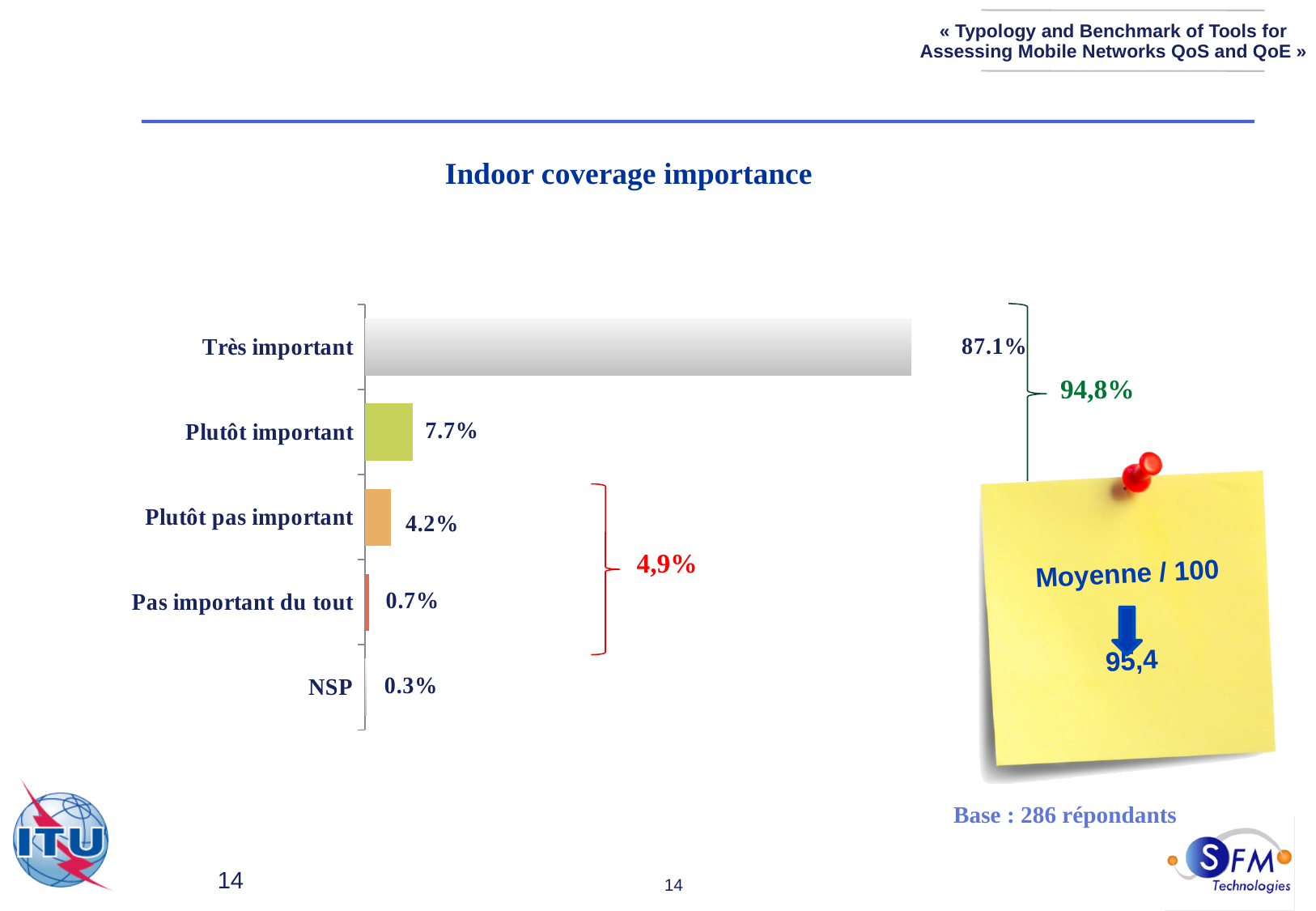
Which is larger, the value for "Plutôt pas important" or the value for "Pas important du tout"? Plutôt pas important What is the difference between the values for "Plutôt important" and "Plutôt pas important"? 3.5% What is the title of the chart? Indoor coverage importance What is the value for "NSP"? 0.3% What kind of chart is shown on the slide? Bar chart What is the value for "Plutôt important"? 7.7% What is the value for "Plutôt pas important"? 4.2% How many categories are shown in the chart? 5 What is the value for "Très important"? 87.1% Which category has the lowest value? NSP What is the value for "Pas important du tout"? 0.7% Which category has the highest value? Très important